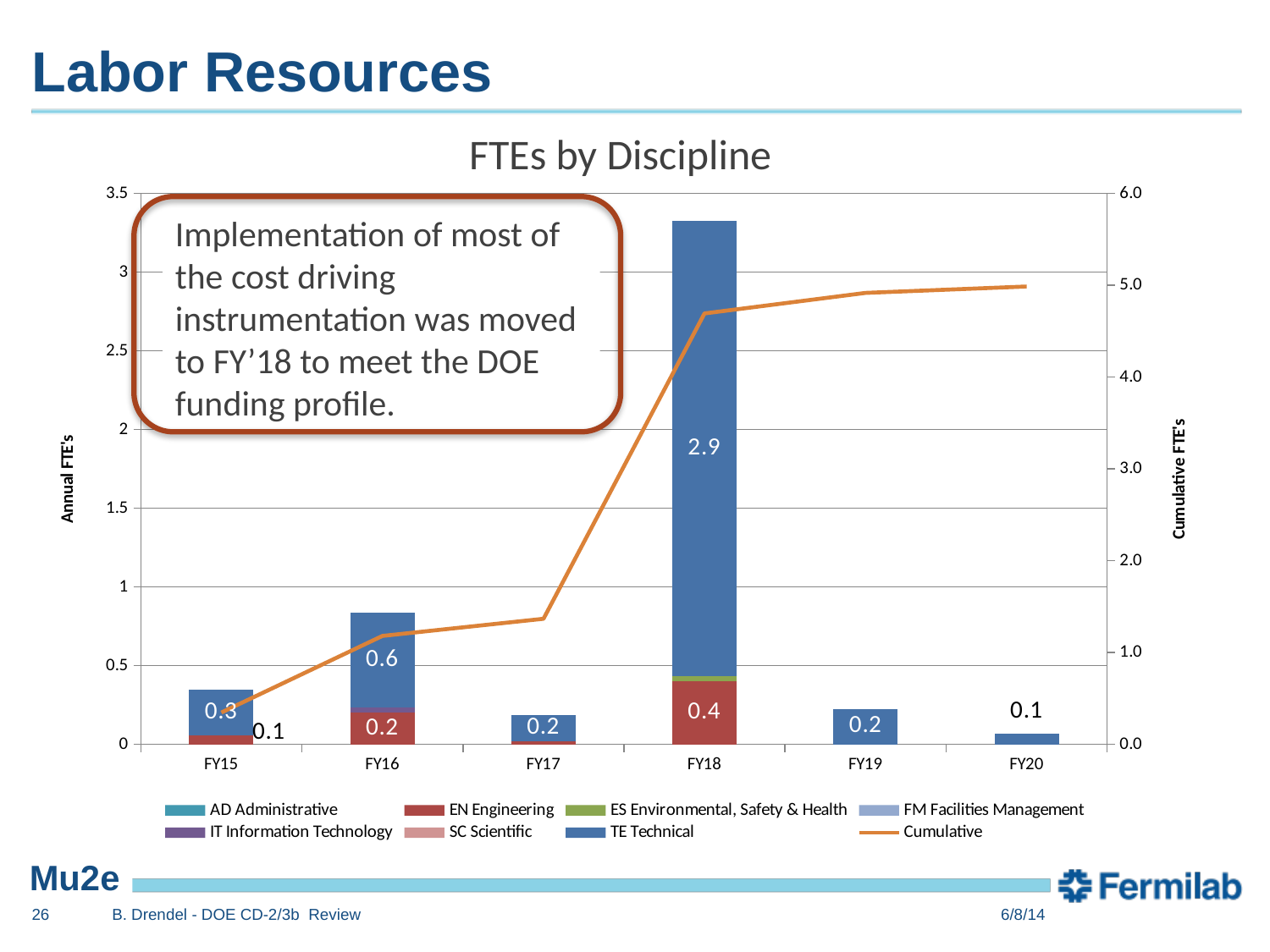
What is the TE Technical value for FY18? 2.9 Is the Cumulative value at FY18 greater or less than 4.0? greater How many entries does the legend list? 8 What kind of chart is used to show the FTEs by discipline? Stacked bar chart with a line What is the TE Technical value for FY16? 0.6 How many fiscal years are shown on the x axis? 6 Which fiscal year has the lowest TE Technical value? FY20 What is the EN Engineering value for FY18? 0.4 What is the title of the chart? FTEs by Discipline Which is larger, the TE Technical value for FY16 or for FY17? FY16 Which fiscal year has the highest TE Technical value? FY18 What is the difference between the TE Technical values for FY18 and FY16? 2.3